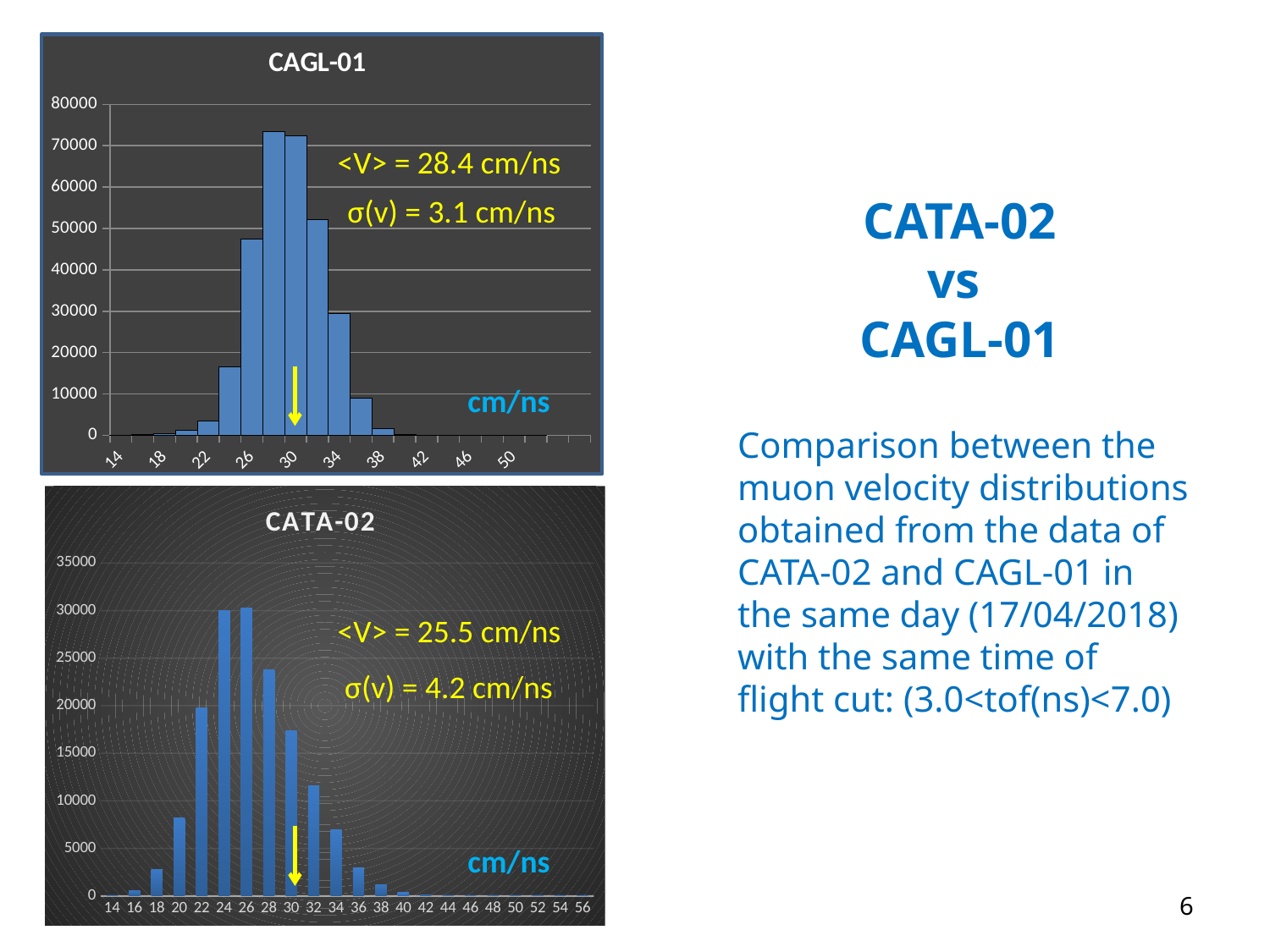
In the CAGL-01 chart, is the value for the bar at 26 greater or less than 40000? greater In the CAGL-01 chart, is the value for the bar at 24 greater or less than 20000? less In the CAGL-01 chart, is the value for the bar at 36 greater or less than 10000? less In the CATA-02 chart, which bar is taller, the one at 20 or the one at 30? 30 In the CATA-02 chart, do the bar values rise or fall from 30 to 40 along the x axis? fall In the CAGL-01 chart, which bar is taller, the one at 26 or the one at 34? 26 In the CAGL-01 chart, what mean velocity <V> is annotated? 28.4 cm/ns In the CATA-02 chart, what value of σ(v) is annotated? 4.2 cm/ns What kind of chart is the CAGL-01 chart? bar chart